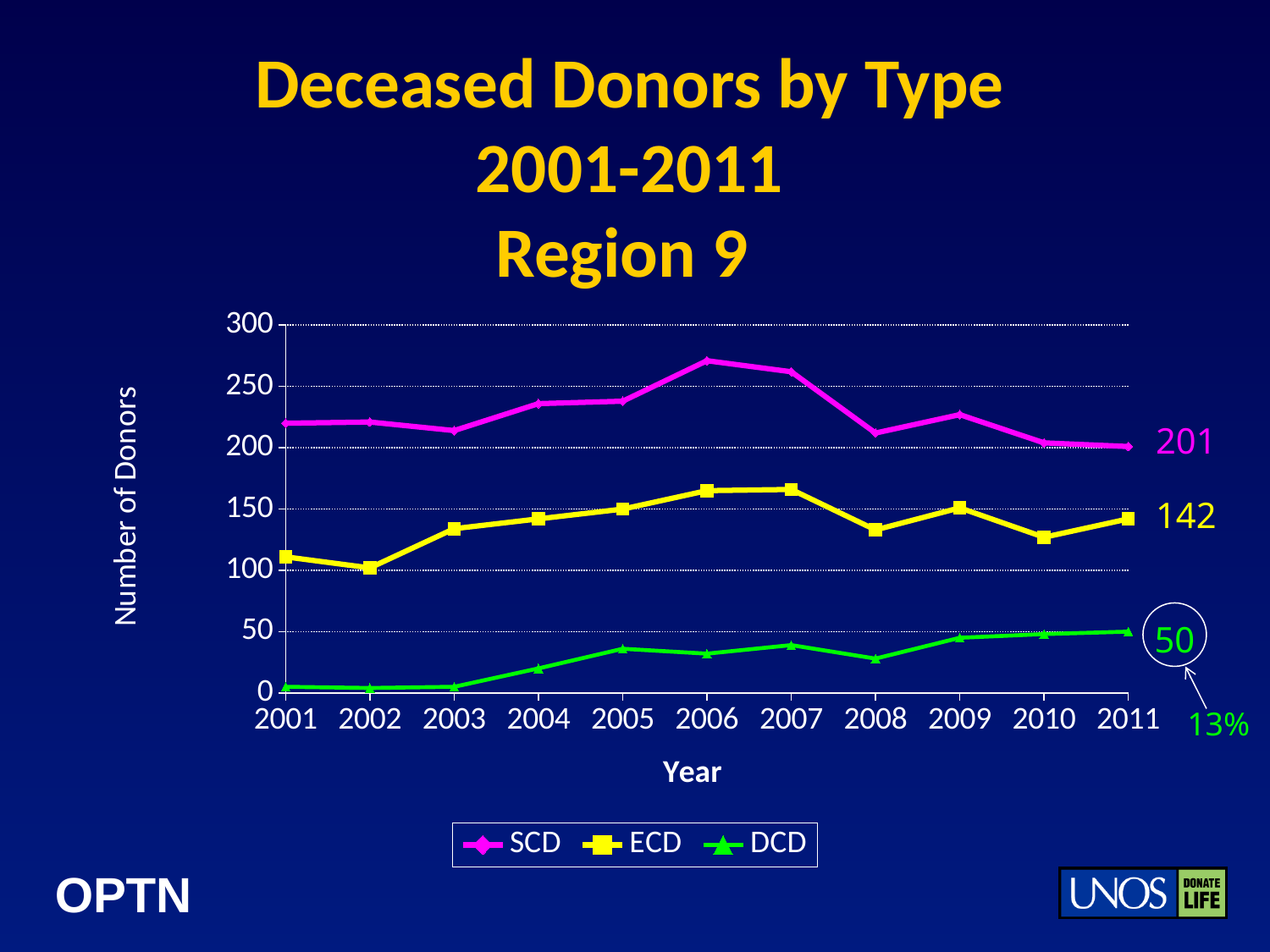
What is the value for SCD in 2011? 201 Is the value for SCD in 2006 greater or less than 250? greater How many series does the legend list? 3 How many years are shown on the x axis? 11 Is the value for DCD in 2005 greater or less than 50? less What is the difference between the ECD and DCD values in 2011? 92 What is the value for ECD in 2011? 142 What is the value for DCD in 2011? 50 In which year does the SCD line reach its highest point? 2006 What is the difference between the SCD and ECD values in 2011? 59 Which series has the highest value in 2011? SCD What kind of chart is shown on the slide? line chart